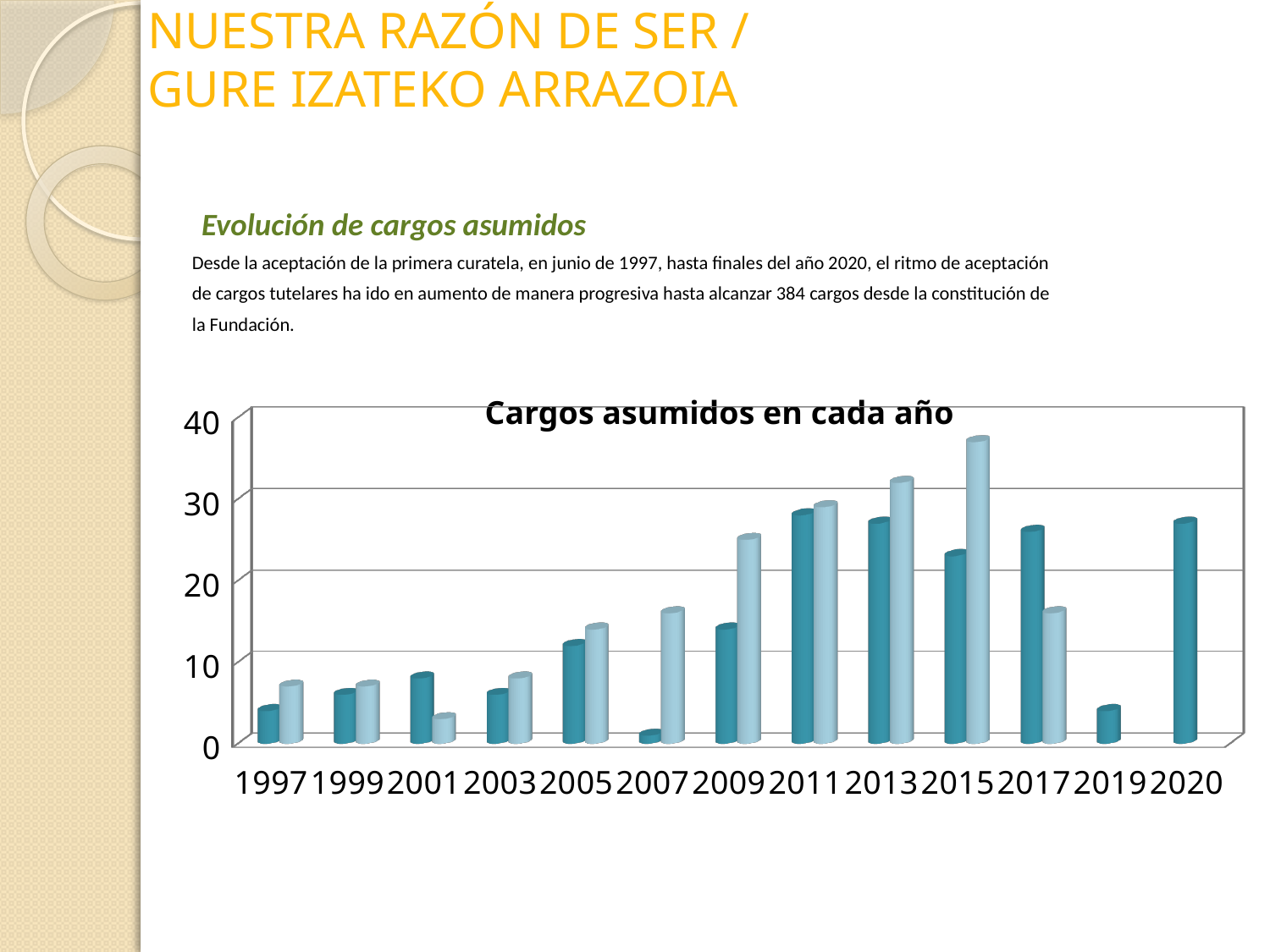
What is the highest value shown on the y axis of the chart? 40 Is the value of the darker bar for 2007 greater or less than 10? less Is the value of the darker bar for 2020 greater or less than 20? greater Which year label has the tallest bar in the chart? 2015 Is the value of the darker bar for 2011 greater or less than 20? greater How many year labels are shown on the x axis of the chart? 13 Which is larger, the darker bar for 2011 or the darker bar for 2019? 2011 What is the title of the chart? Cargos asumidos en cada año What type of chart is shown on the slide? bar chart